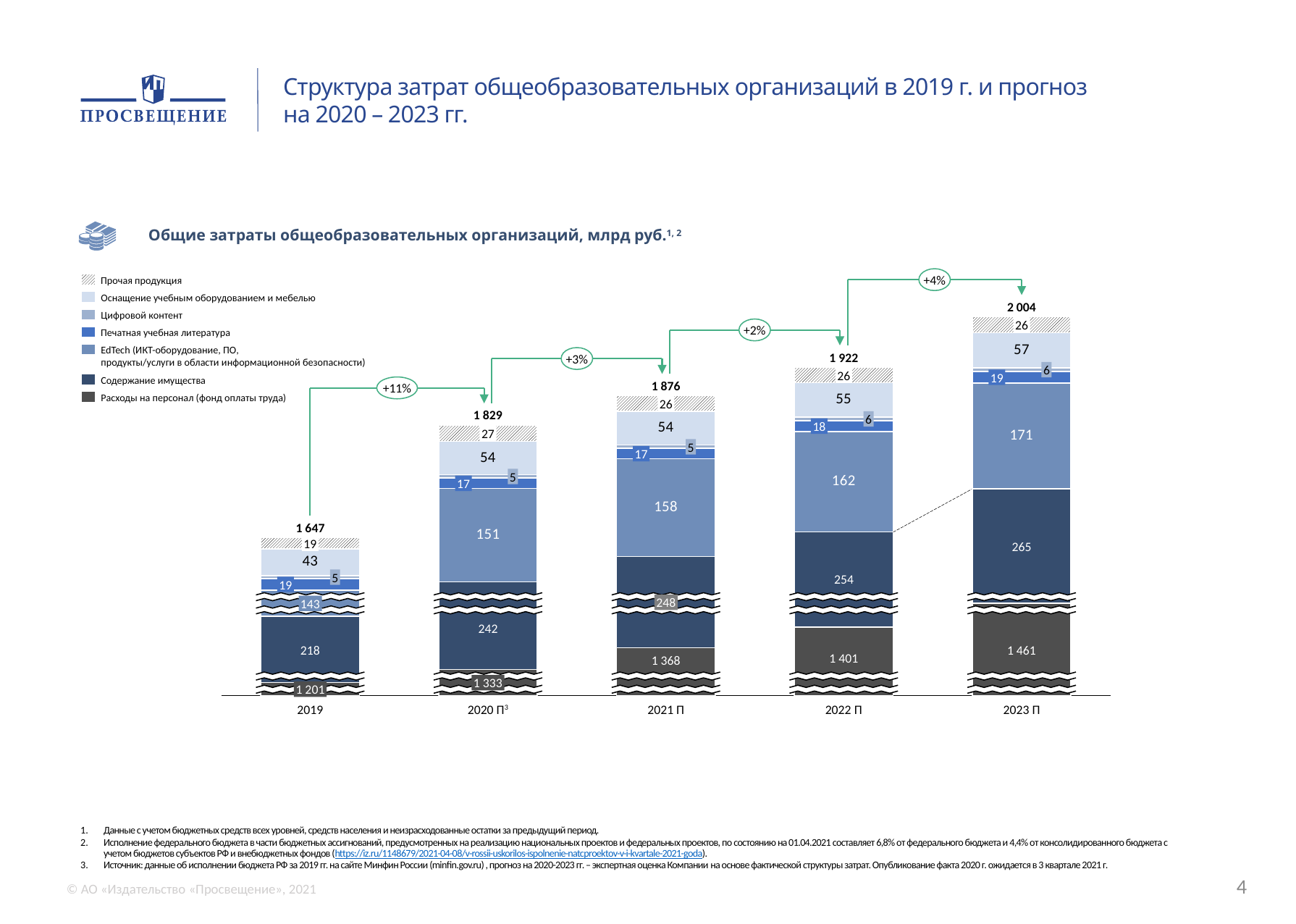
How many series does the legend list? 7 How many years (bars) are shown on the chart? 5 Which year has the lowest total expenditure? 2019 What is the difference between the total for 2020 П and the total for 2019? 182 What is the total value shown above the bar for 2023 П? 2 004 Which is larger: Оснащение учебным оборудованием и мебелью in 2023 П or in 2019? 2023 П What is the value of Содержание имущества for 2022 П? 254 Which year has the highest total expenditure? 2023 П What percentage growth is shown between 2019 and 2020 П? +11% What kind of chart is shown on the slide? Stacked bar chart What is the value of Расходы на персонал (фонд оплаты труда) for 2019? 1 201 What is the value of EdTech for 2021 П? 158